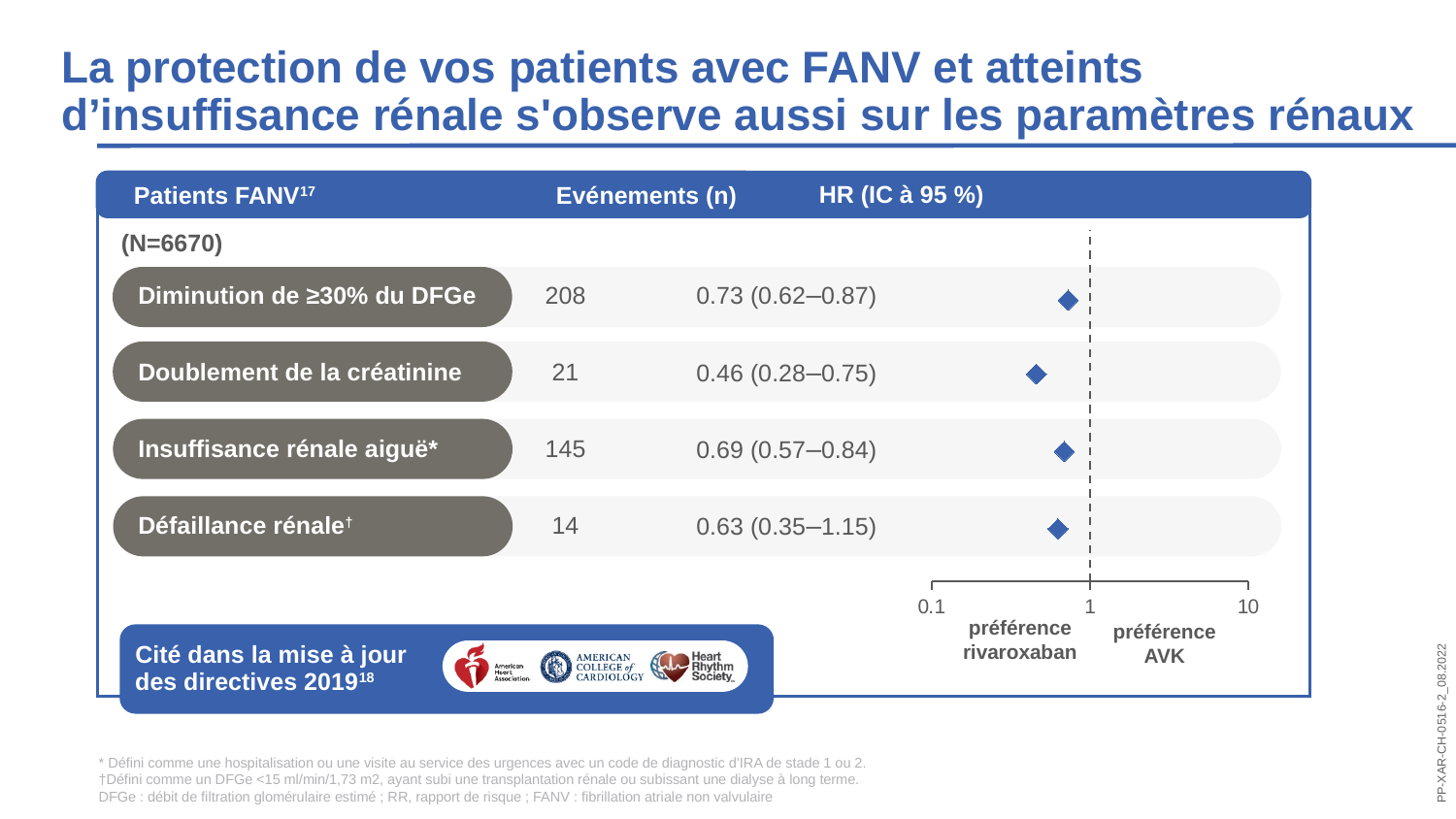
Which outcome has the lowest hazard ratio point estimate? Doublement de la créatinine How many outcomes are plotted in the forest plot? 4 Which has more events: 'Doublement de la créatinine' or 'Défaillance rénale†'? Doublement de la créatinine What is the difference in the number of events between 'Diminution de ≥30% du DFGe' and 'Insuffisance rénale aiguë*'? 63 What kind of chart is shown on the slide? Forest plot What is the total number of patients (N) in the study shown? N=6670 Which outcome has the highest number of events (n)? Diminution de ≥30% du DFGe How many events (n) are reported for 'Défaillance rénale†'? 14 What is the hazard ratio (HR) for 'Diminution de ≥30% du DFGe'? 0.73 (0.62–0.87) How many events (n) are reported for 'Insuffisance rénale aiguë*'? 145 What is the HR with 95% CI for 'Doublement de la créatinine'? 0.46 (0.28–0.75) Is the HR point estimate for 'Défaillance rénale†' greater or less than 1? less